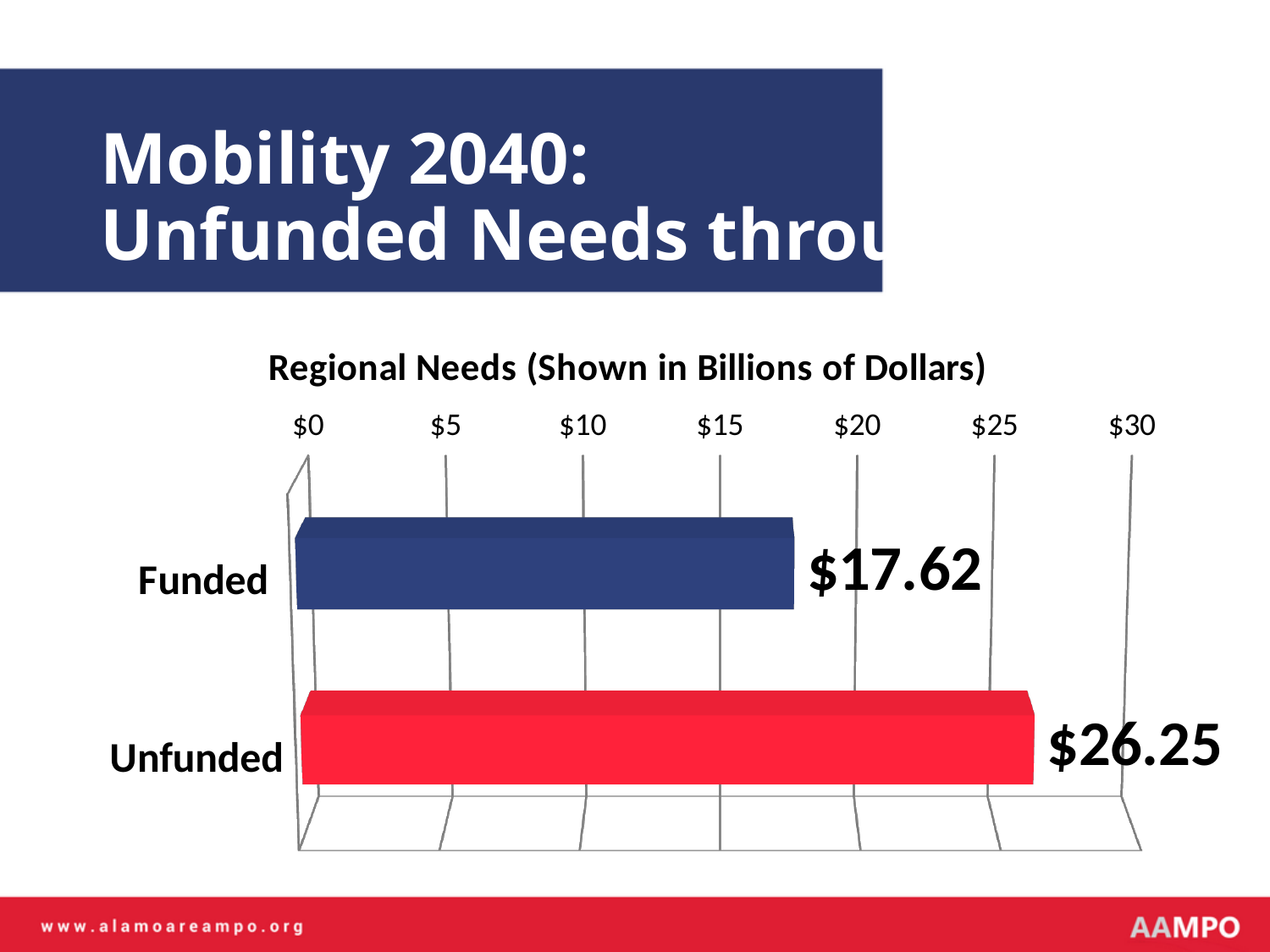
Which category has the lowest value? Funded What is the value for Unfunded? $26.25 What is the value for Funded? $17.62 Is the value for Unfunded greater or less than $25? greater How many categories are shown in the chart? 2 What is the title of the chart? Regional Needs (Shown in Billions of Dollars) Which category has the highest value? Unfunded What kind of chart is shown? bar chart What is the difference between the Unfunded and Funded values? $8.63 Which is larger, Funded or Unfunded? Unfunded What colour is the Unfunded bar? red Is the value for Funded greater or less than $20? less